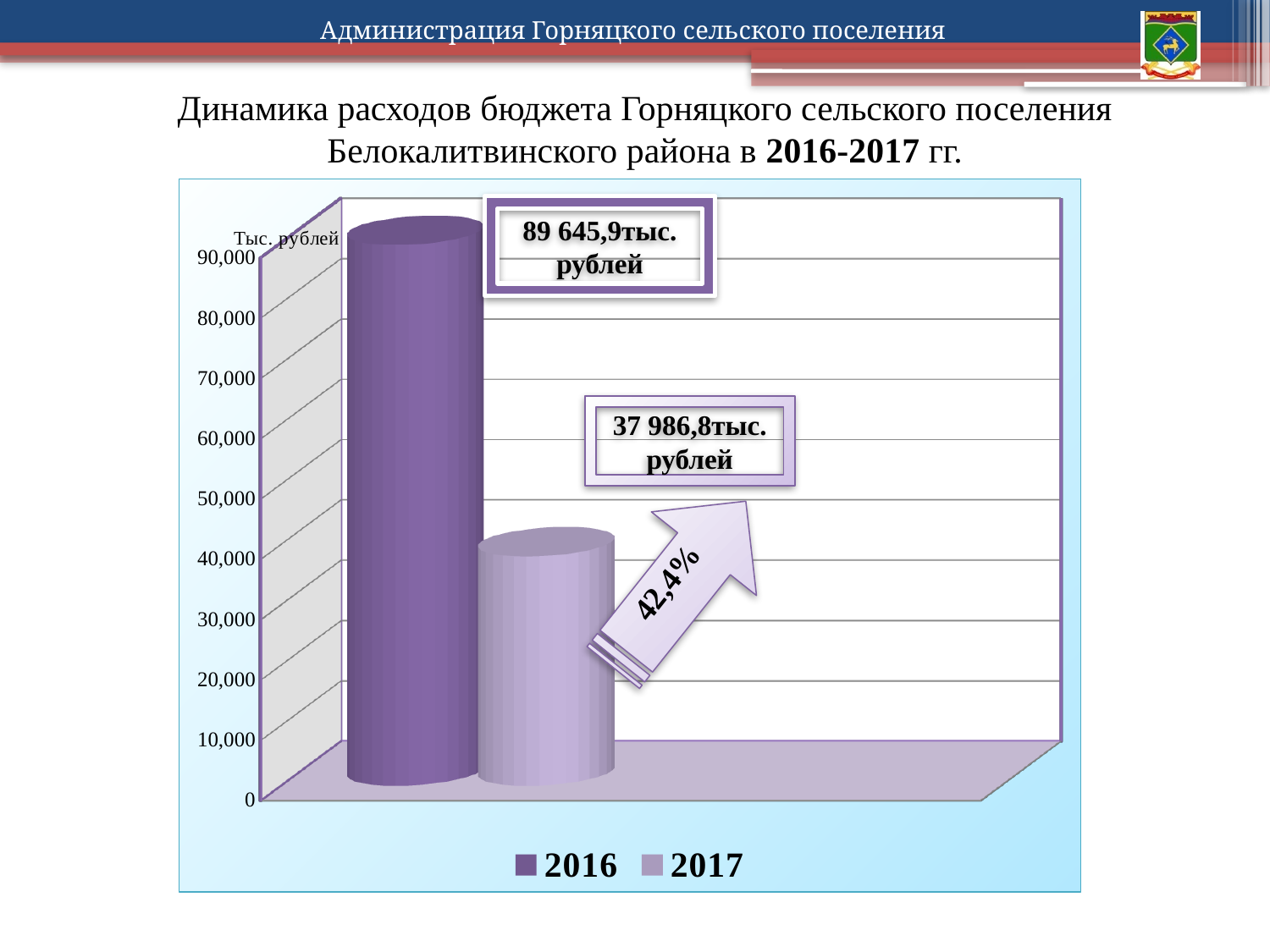
What is the budget expenditure value shown for 2017? 37 986,8 тыс. рублей Is the value for 2017 greater or less than 50,000? less Which year has the lower expenditure value? 2017 Do the expenditure values rise or fall from 2016 to 2017? fall How many series does the legend list? 2 What is the difference between the 2016 and 2017 expenditure values? 51 659,1 тыс. рублей What percentage is written on the arrow in the chart? 42,4% What kind of chart is shown on the slide? bar chart What is the budget expenditure value shown for 2016? 89 645,9 тыс. рублей Is the value for 2016 larger or smaller than the value for 2017? larger Is the value for 2016 greater or less than 80,000? greater Which year has the higher expenditure value? 2016